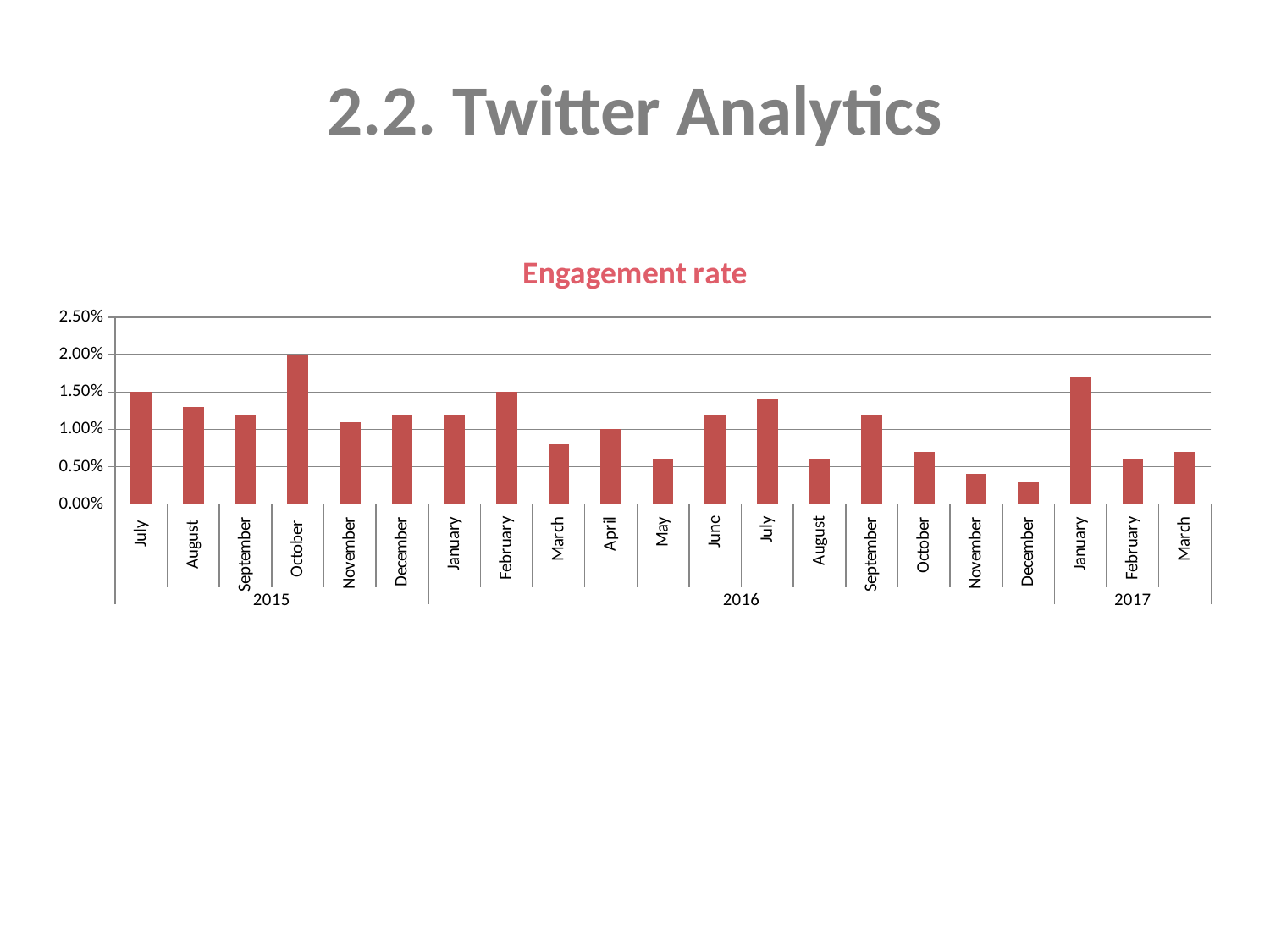
What is the engagement rate for April 2016? 1.00% Which month has the highest engagement rate? October 2015 What is the title of the chart? Engagement rate What is the engagement rate for July 2015? 1.50% Does the engagement rate rise or fall from September 2016 to December 2016? fall Is the engagement rate for January 2017 greater or less than 1.50%? greater Is the engagement rate for December 2016 greater or less than 0.50%? less What is the engagement rate for October 2015? 2.00% How many months are plotted in the chart? 21 What is the difference between the engagement rates for October 2015 and February 2016? 0.50% Which is larger, the engagement rate for June 2016 or for May 2016? June 2016 What kind of chart is shown on the slide? bar chart